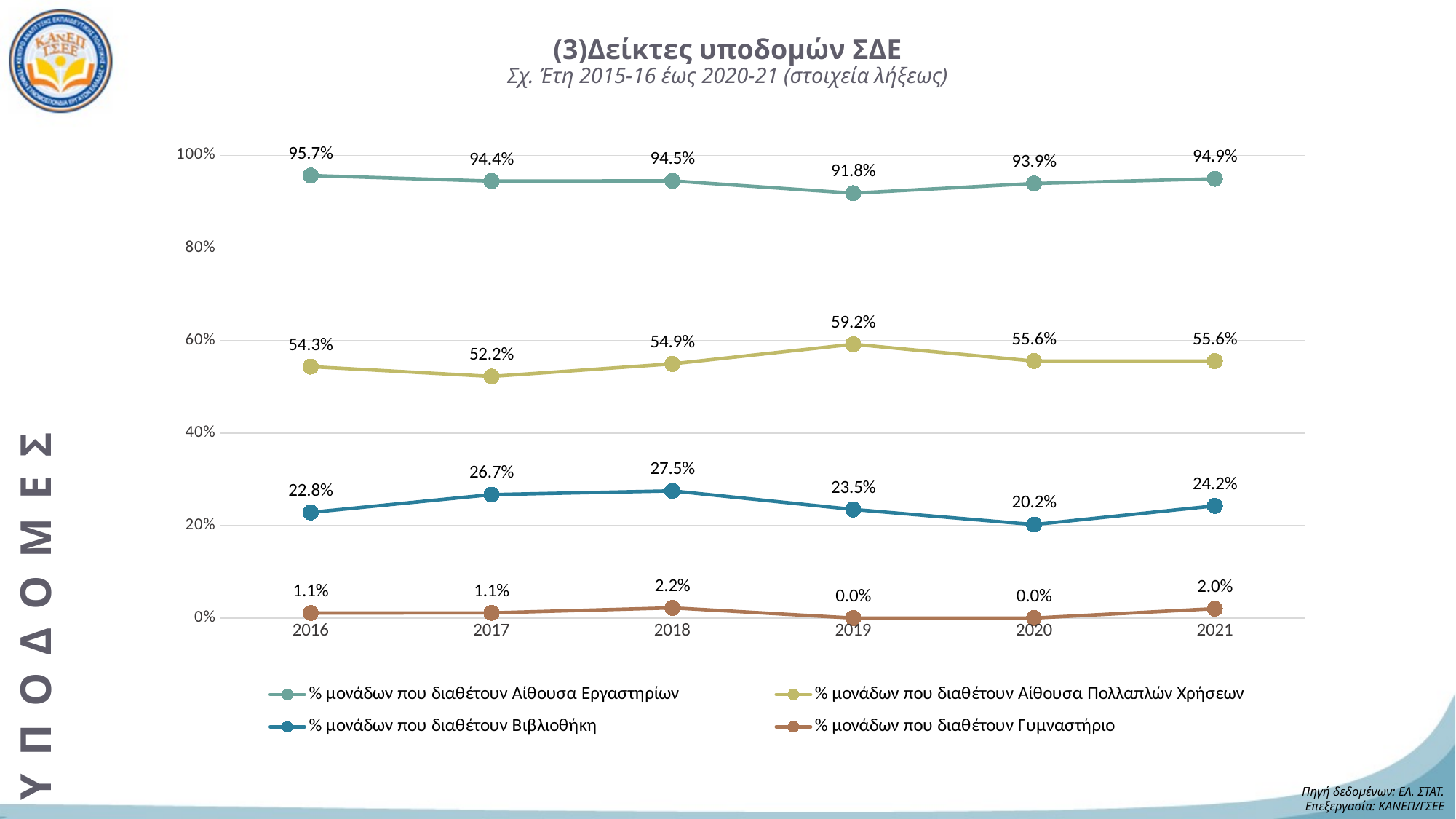
What is the difference between the 2016 and 2019 values for % μονάδων που διαθέτουν Αίθουσα Εργαστηρίων? 3.9% In which year is % μονάδων που διαθέτουν Βιβλιοθήκη lowest? 2020 What is the value for % μονάδων που διαθέτουν Αίθουσα Πολλαπλών Χρήσεων in 2018? 54.9% What is the value for % μονάδων που διαθέτουν Αίθουσα Εργαστηρίων in 2019? 91.8% Does % μονάδων που διαθέτουν Βιβλιοθήκη rise or fall from 2018 to 2020? fall How many years are shown on the x axis? 6 How many series does the legend list? 4 Which is larger for % μονάδων που διαθέτουν Γυμναστήριο: the 2018 value or the 2021 value? 2018 Is the value for % μονάδων που διαθέτουν Βιβλιοθήκη in 2018 greater or less than 20%? greater In which year is % μονάδων που διαθέτουν Αίθουσα Πολλαπλών Χρήσεων highest? 2019 What kind of chart is shown on the slide? line chart What is the value for % μονάδων που διαθέτουν Βιβλιοθήκη in 2020? 20.2%